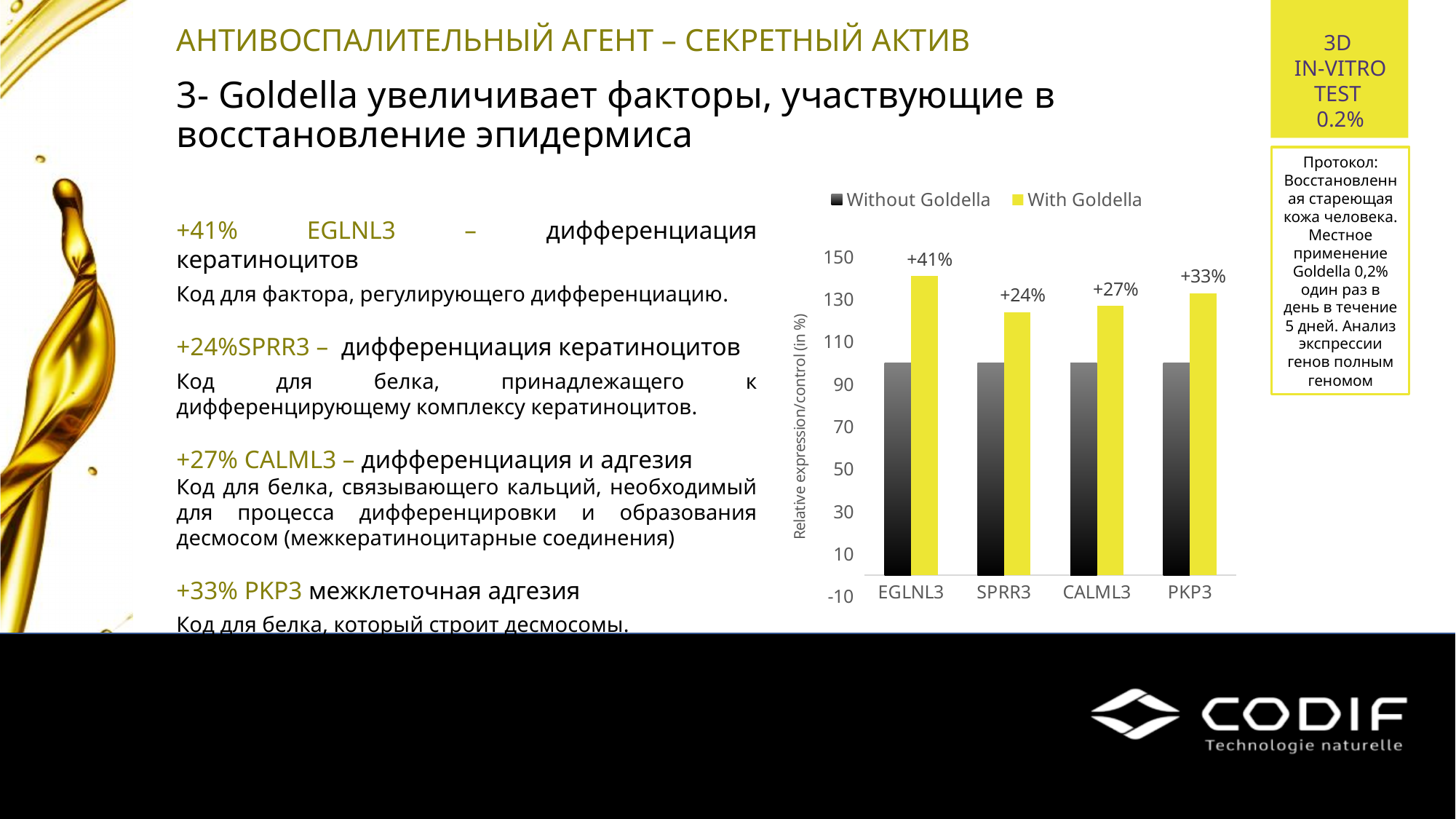
Is the Without Goldella value for PKP3 greater or less than 90? greater Which category has the highest With Goldella value? EGLNL3 How many categories are shown on the x axis of the chart? 4 Is the With Goldella value for SPRR3 greater or less than 130? less What kind of chart is shown on the slide? bar chart Which has the larger With Goldella value, CALML3 or SPRR3? CALML3 Which category has the lowest With Goldella value? SPRR3 What is the data label on the With Goldella bar for PKP3? +33% What is the data label on the With Goldella bar for SPRR3? +24% How many series does the chart legend list? 2 What is the title of the chart's vertical axis? Relative expression/control (in %) What is the data label on the With Goldella bar for EGLNL3? +41%